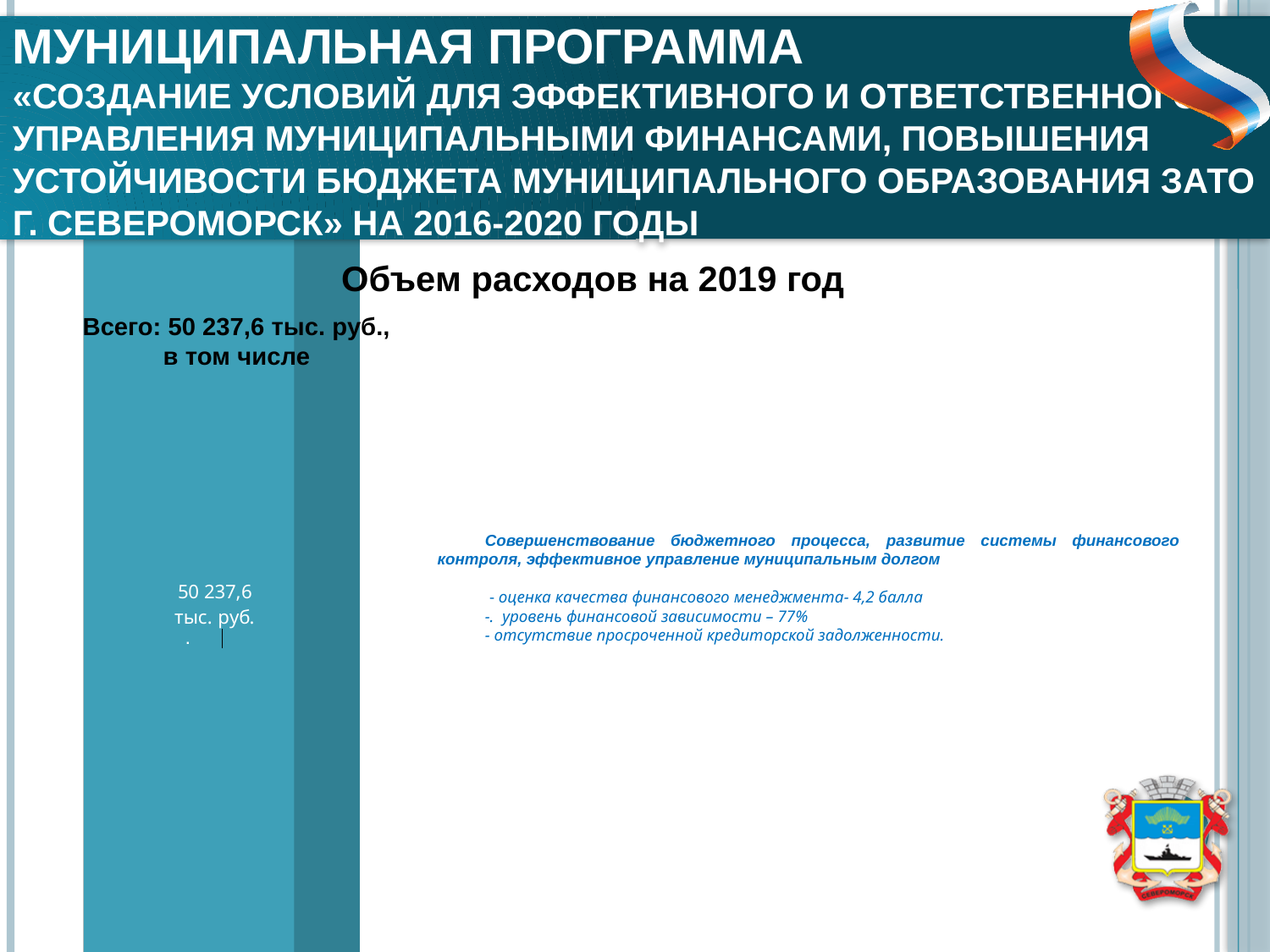
What is the title of the chart? Объем расходов на 2019 год What value is printed on the bar in the chart? 50 237,6 тыс. руб. How many bars does the chart show? 1 What kind of chart is shown on the slide? bar chart What colour is the bar in the chart? teal (blue-green) What total expenditure amount is stated above the chart? 50 237,6 тыс. руб.